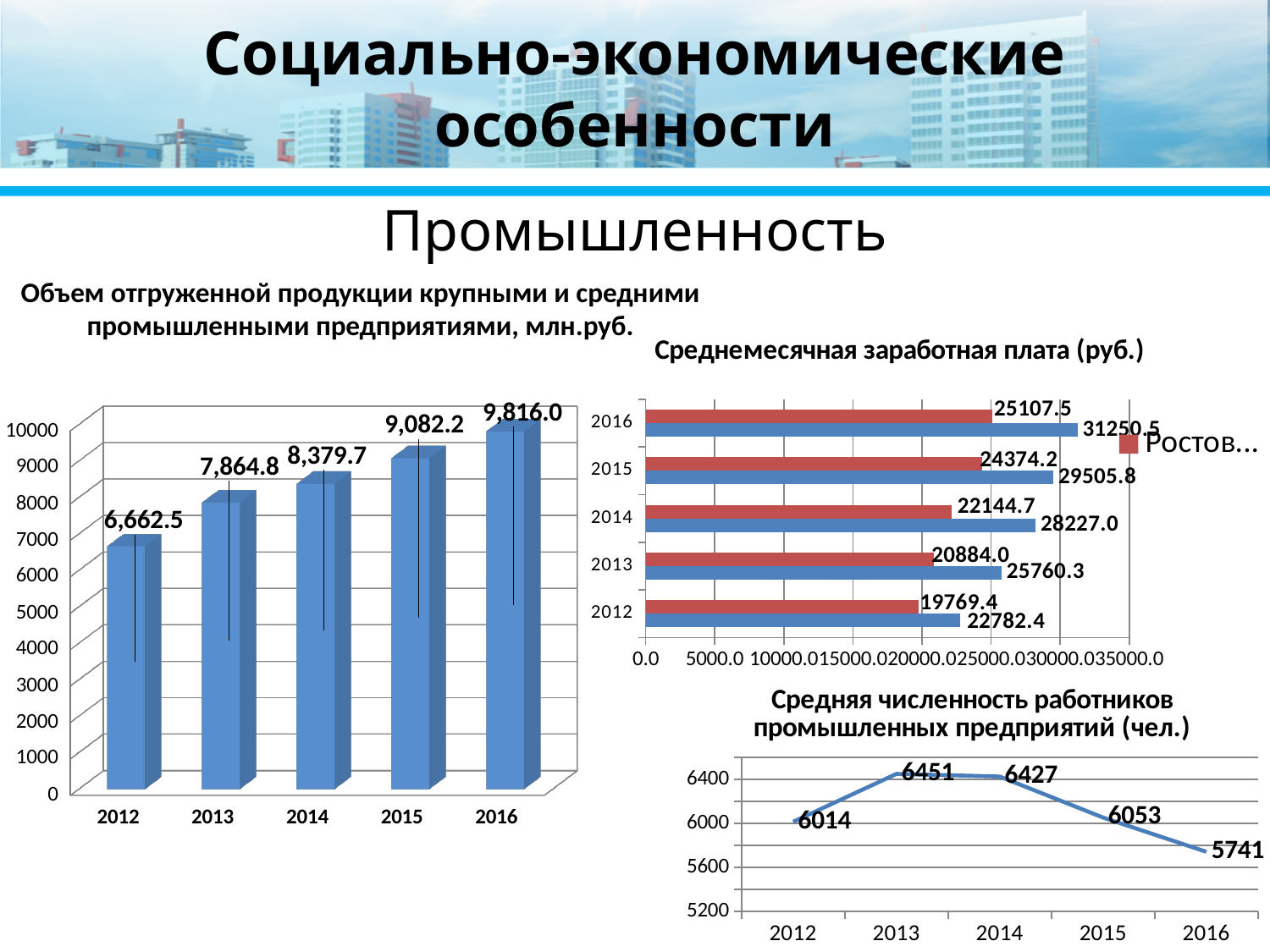
In the chart 'Среднемесячная заработная плата (руб.)', what is the value of the blue bar for 2016? 31250.5 What kind of chart is 'Объем отгруженной продукции крупными и средними промышленными предприятиями, млн.руб.'? bar chart In the chart 'Средняя численность работников промышленных предприятий (чел.)', which year has the lowest value? 2016 In the chart 'Объем отгруженной продукции крупными и средними промышленными предприятиями, млн.руб.', what is the value for 2012? 6,662.5 In the chart 'Среднемесячная заработная плата (руб.)', how many years are shown? 5 In the chart 'Объем отгруженной продукции крупными и средними промышленными предприятиями, млн.руб.', which year has the highest value? 2016 In the chart 'Среднемесячная заработная плата (руб.)', what is the value of the red bar for 2012? 19769.4 What kind of chart is 'Средняя численность работников промышленных предприятий (чел.)'? line chart In the chart 'Объем отгруженной продукции крупными и средними промышленными предприятиями, млн.руб.', what is the difference between the 2016 and 2015 values? 733.8 In the chart 'Среднемесячная заработная плата (руб.)', which is larger for 2014: the red bar or the blue bar? the blue bar In the chart 'Объем отгруженной продукции крупными и средними промышленными предприятиями, млн.руб.', do the values rise or fall from 2012 to 2016? rise In the chart 'Средняя численность работников промышленных предприятий (чел.)', what is the value for 2013? 6451